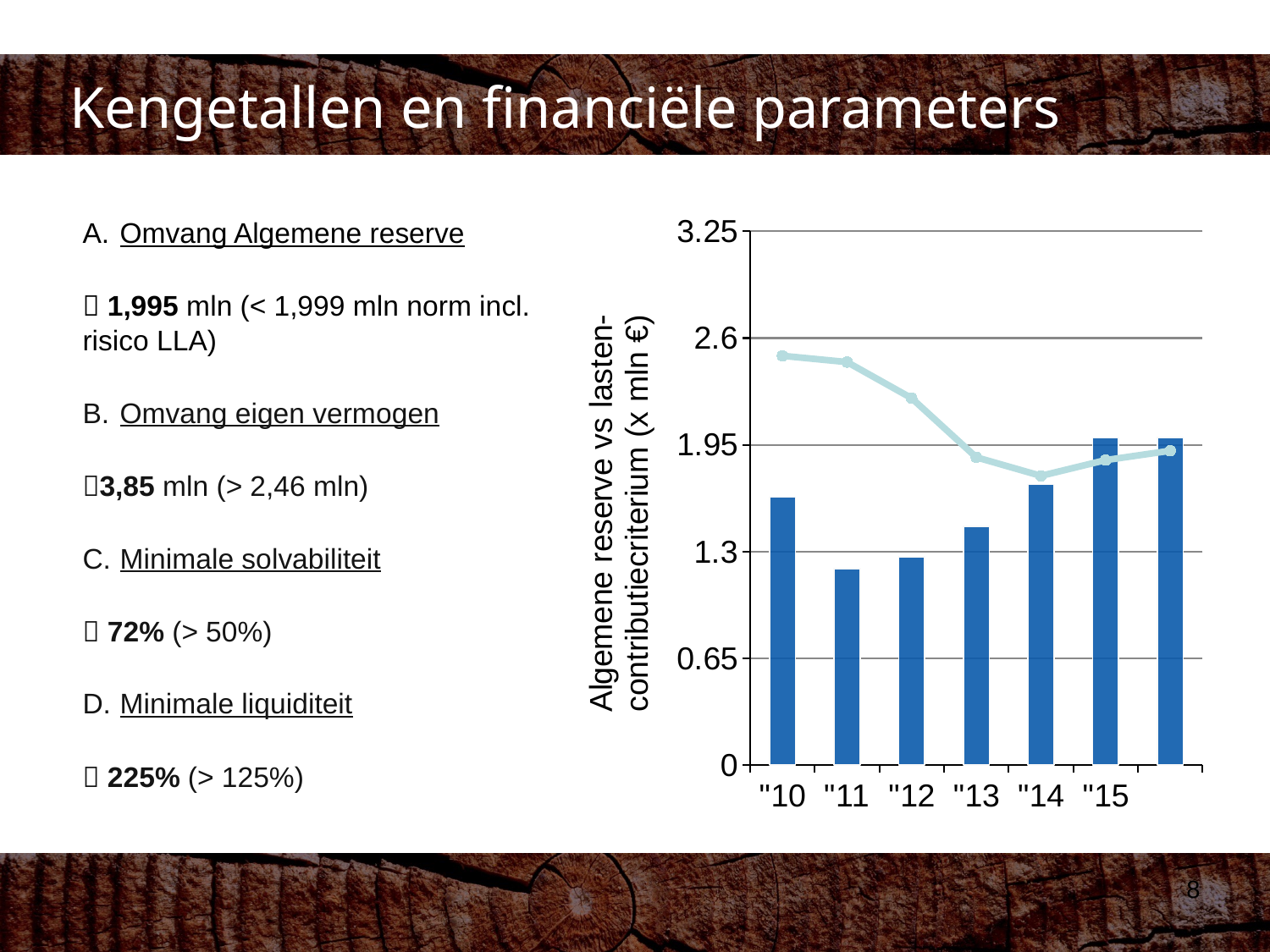
Is the line value for "12 greater or less than 1.95? greater Is the line value for "10 greater or less than 2.6? less Does the line rise or fall from "10 to "14? Fall Is the bar value for "14 greater or less than 1.95? less Which labelled year has the lowest bar? "11 What kind of chart is shown on the slide? A combined bar and line chart How many year labels are shown on the x axis of the chart? 6 Which is larger at "10, the bar value or the line value? The line value What is the y-axis title of the chart? Algemene reserve vs lasten-contributiecriterium (x mln €)